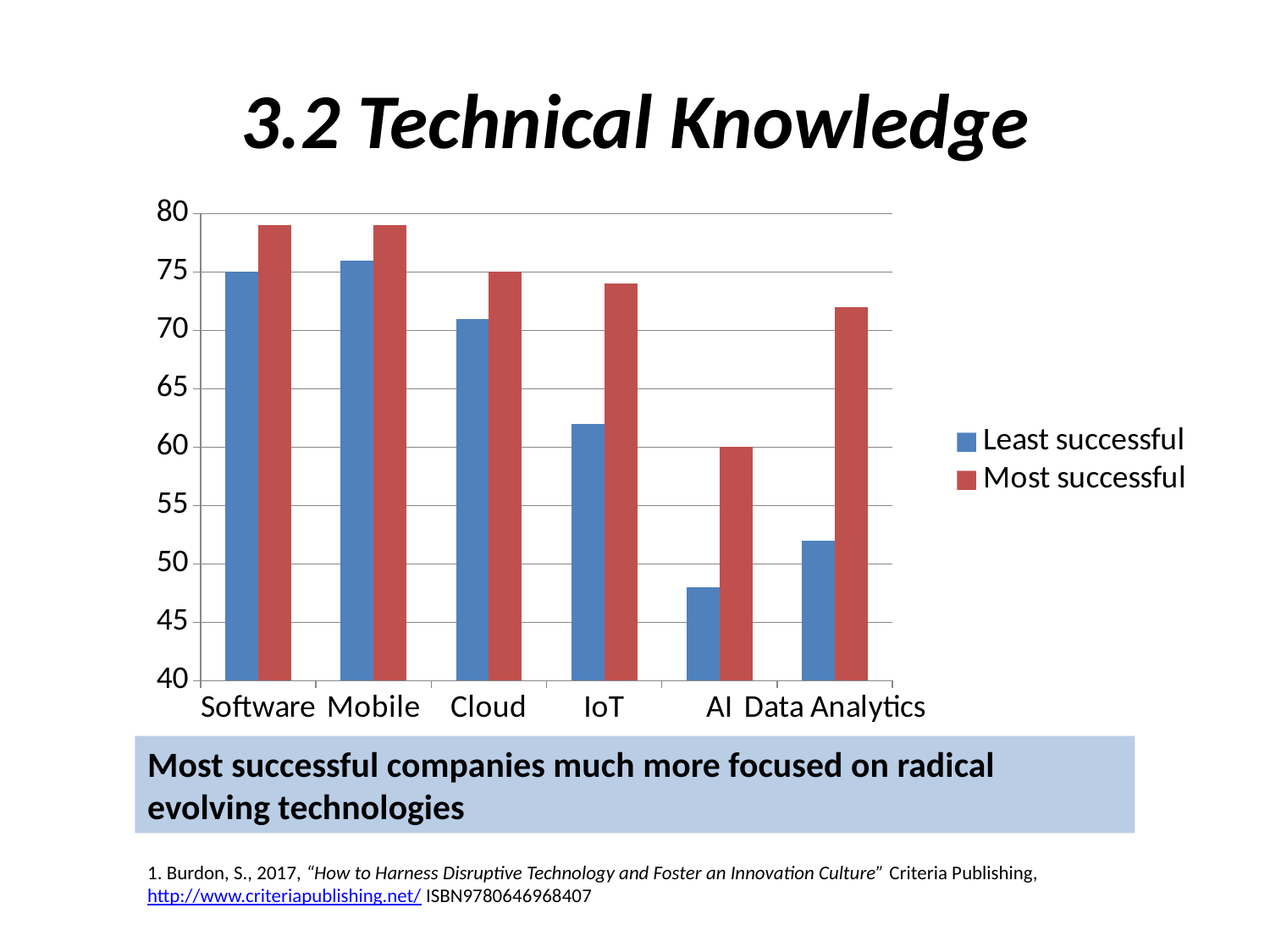
Which series is shown in red? Most successful What is the Least successful value for Software? 75 What kind of chart is shown on the slide? bar chart What is the Most successful value for Cloud? 75 How many categories are shown on the x axis? 6 Which category has the lowest Least successful value? AI What is the Most successful value for AI? 60 How many series does the legend list? 2 Is the Least successful value for IoT greater or less than 60? greater Which category has the lowest Most successful value? AI For Data Analytics, which series has the larger value, Least successful or Most successful? Most successful Is the Least successful value for Data Analytics greater or less than 55? less